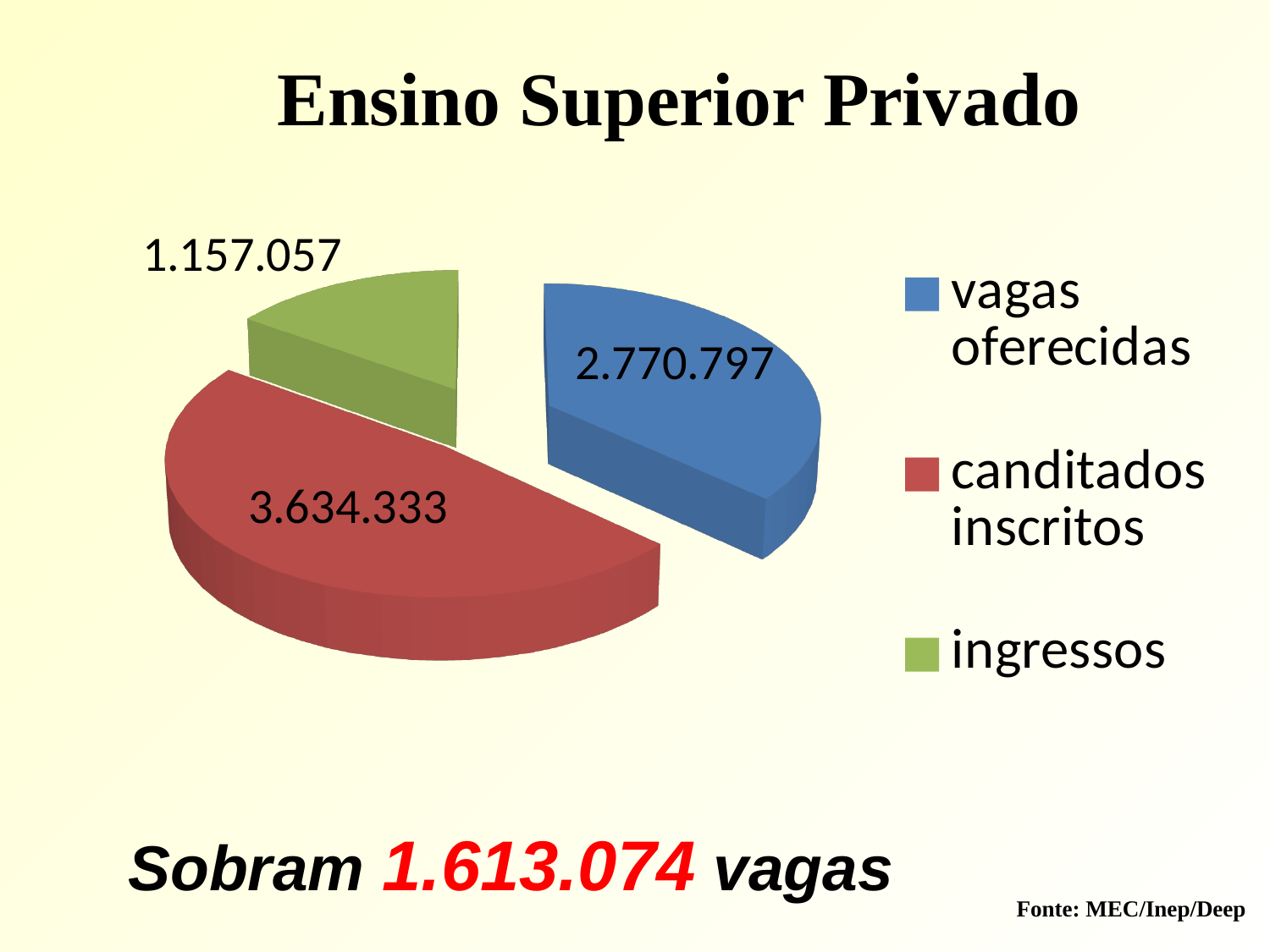
What is the title of the chart on the slide? Ensino Superior Privado Which is larger, 'vagas oferecidas' or 'ingressos'? vagas oferecidas What kind of chart is shown on the slide? pie chart Which colour represents 'ingressos' in the pie chart? green What is the value for 'ingressos'? 1.157.057 Which category has the largest slice of the pie? canditados inscritos How many slices does the pie chart have? 3 How many entries does the legend list? 3 What is the difference between 'canditados inscritos' and 'vagas oferecidas'? 863.536 Which category has the smallest slice of the pie? ingressos What is the value for 'vagas oferecidas'? 2.770.797 What is the value for 'canditados inscritos'? 3.634.333